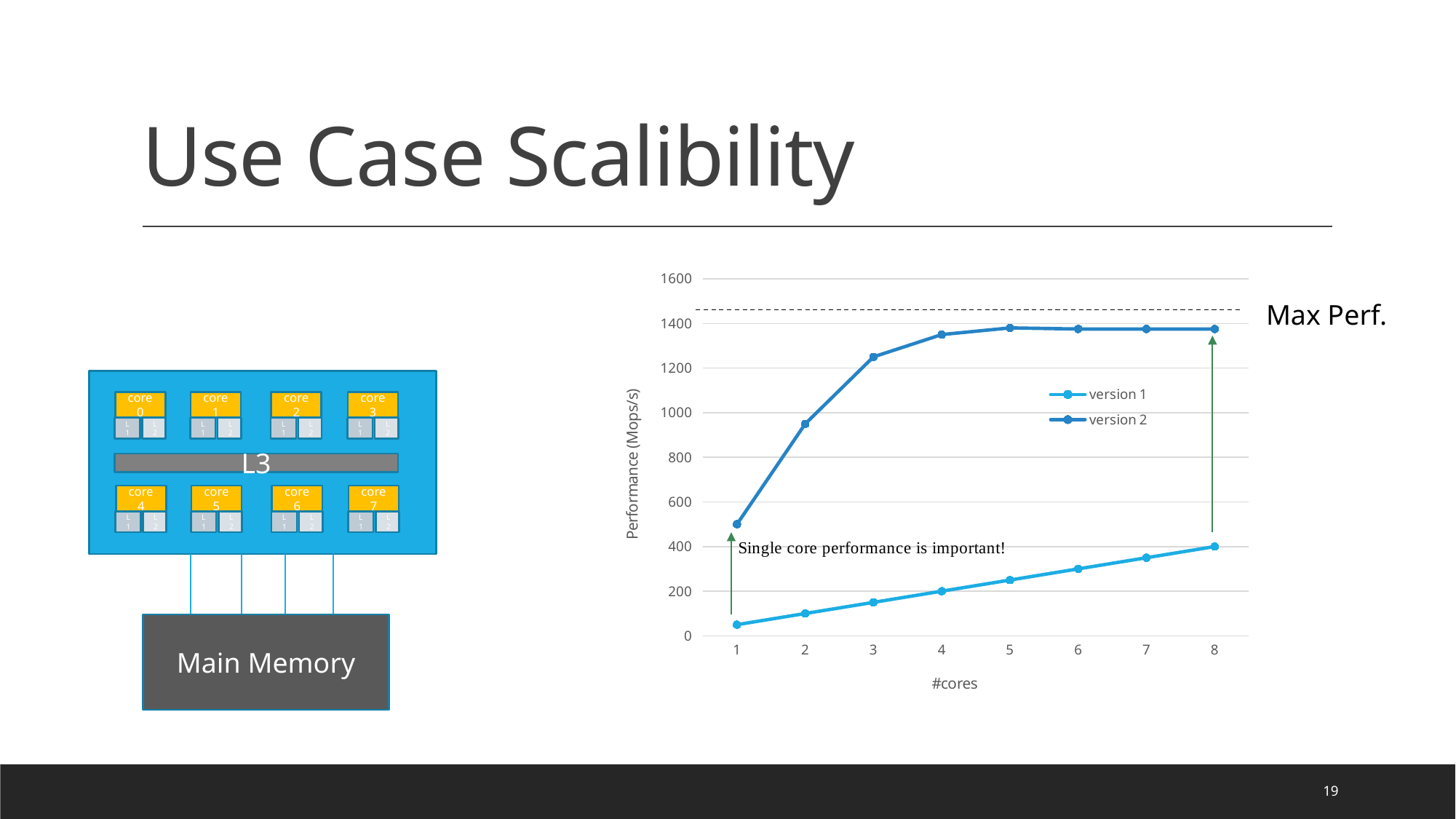
Is the value for version 2 at 8 cores greater or less than 1200? greater Does the performance of version 1 rise or fall as the number of cores increases? rise At which number of cores is version 2's performance lowest? 1 Is the value for version 2 at 1 core greater or less than 400? greater At which number of cores does version 1 reach its highest performance? 8 What kind of chart is shown on the slide? line chart What is the performance of version 1 at 8 cores? 400 How many #cores values are plotted along the x axis? 8 Is the value for version 1 at 1 core greater or less than 200? less How many series does the chart legend list? 2 What is the performance of version 1 at 4 cores? 200 At 4 cores, which series has the higher performance, version 1 or version 2? version 2